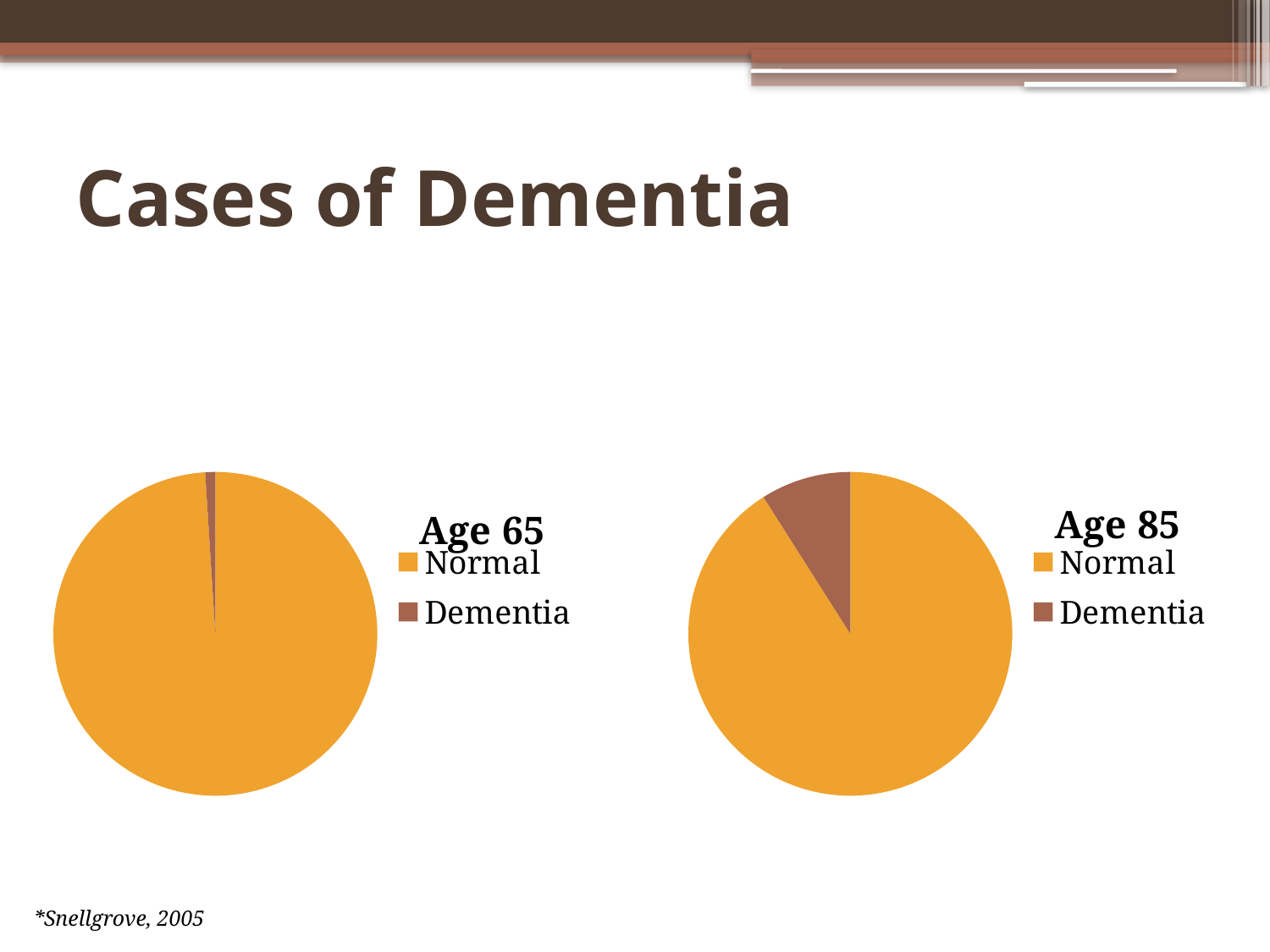
In the "Age 65" chart, which category has the smallest slice? Dementia What kind of chart is the "Age 85" chart? Pie chart What is the title of the pie chart on the left of the slide? Age 65 In the "Age 65" chart, which category has the largest slice? Normal In the "Age 85" chart, how many categories does the legend list? 2 In the "Age 85" chart, what colour represents the Dementia slice? Brown In the "Age 85" chart, which is larger, the Normal slice or the Dementia slice? Normal In the "Age 85" chart, which category has the largest slice? Normal In the "Age 85" chart, which category has the smallest slice? Dementia In the "Age 65" chart, how many slices does the pie have? 2 Is the Dementia slice larger in the "Age 65" chart or the "Age 85" chart? Age 85 What kind of chart is the "Age 65" chart? Pie chart